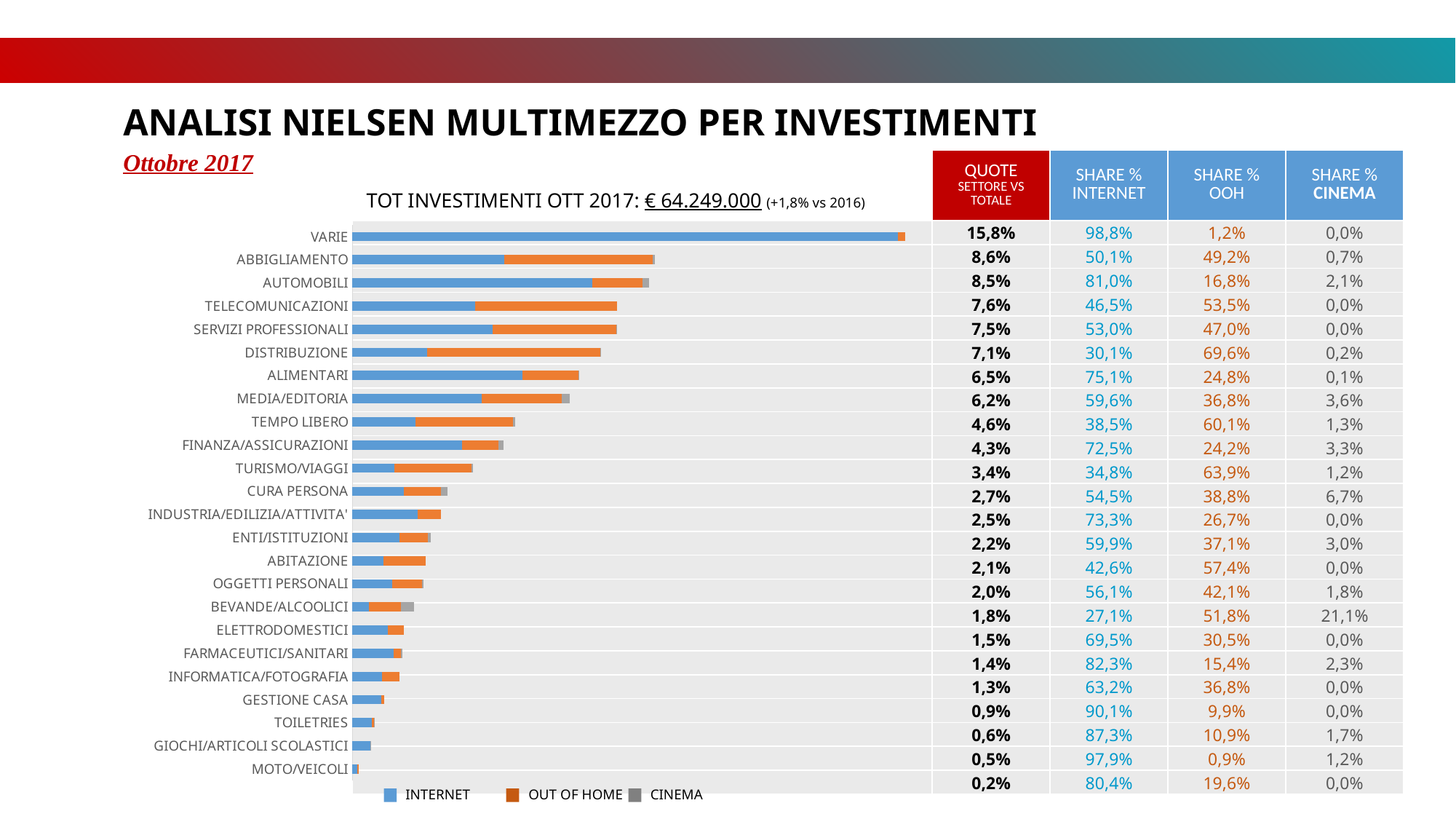
What total investment amount for October 2017 is stated above the chart? € 64.249.000 What is the QUOTE SETTORE VS TOTALE value for VARIE? 15,8% What is the SHARE % OOH value for DISTRIBUZIONE? 69,6% How many sector categories are plotted in the chart? 24 What kind of chart is shown on the slide? bar chart What is the SHARE % INTERNET value for AUTOMOBILI? 81,0% Which sector has the larger QUOTE SETTORE VS TOTALE, ALIMENTARI or TEMPO LIBERO? ALIMENTARI How many series does the chart legend list? 3 What is the difference between the SHARE % INTERNET of VARIE and that of ABBIGLIAMENTO? 48,7% Which sector has the highest QUOTE SETTORE VS TOTALE? VARIE Which sector has the lowest QUOTE SETTORE VS TOTALE? MOTO/VEICOLI What is the SHARE % CINEMA value for BEVANDE/ALCOOLICI? 21,1%